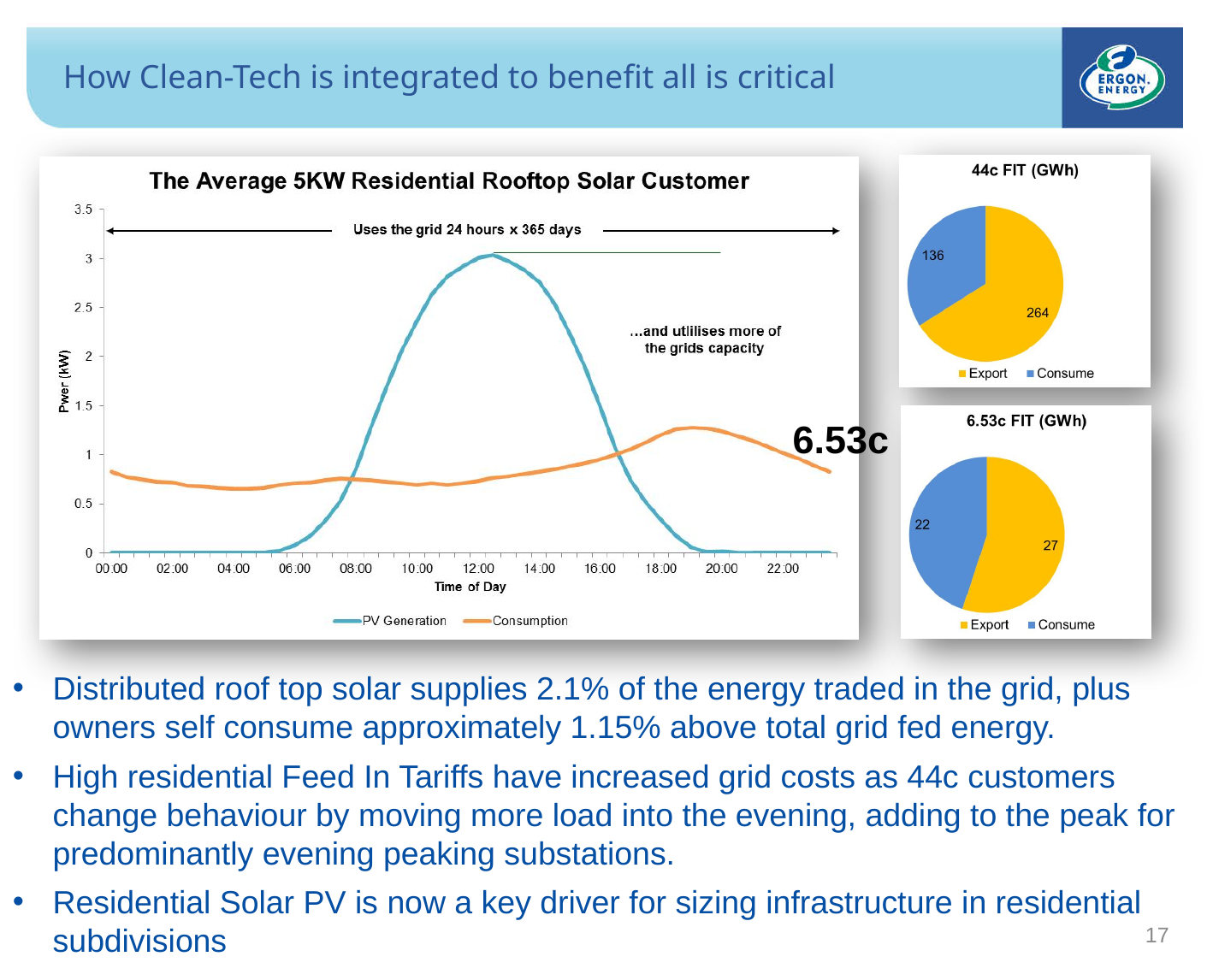
In the 6.53c FIT (GWh) pie chart, what is the value for Export? 27 In 'The Average 5KW Residential Rooftop Solar Customer' chart, is the PV Generation value at 12:00 greater or less than 2.5? greater In the 44c FIT (GWh) pie chart, what share of the total does Export represent? 66% In the 6.53c FIT (GWh) pie chart, what is the value for Consume? 22 In 'The Average 5KW Residential Rooftop Solar Customer' chart, which series has the higher value at 12:00, PV Generation or Consumption? PV Generation How many series does the legend of the 6.53c FIT (GWh) pie chart list? 2 In 'The Average 5KW Residential Rooftop Solar Customer' chart, is the Consumption value at 19:00 greater or less than 1? greater In the 44c FIT (GWh) pie chart, what is the value for Export? 264 What kind of chart is 'The Average 5KW Residential Rooftop Solar Customer'? Line chart In the 44c FIT (GWh) pie chart, what is the value for Consume? 136 In the 6.53c FIT (GWh) pie chart, which is larger, Export or Consume? Export In the 44c FIT (GWh) pie chart, what is the difference between Export and Consume? 128